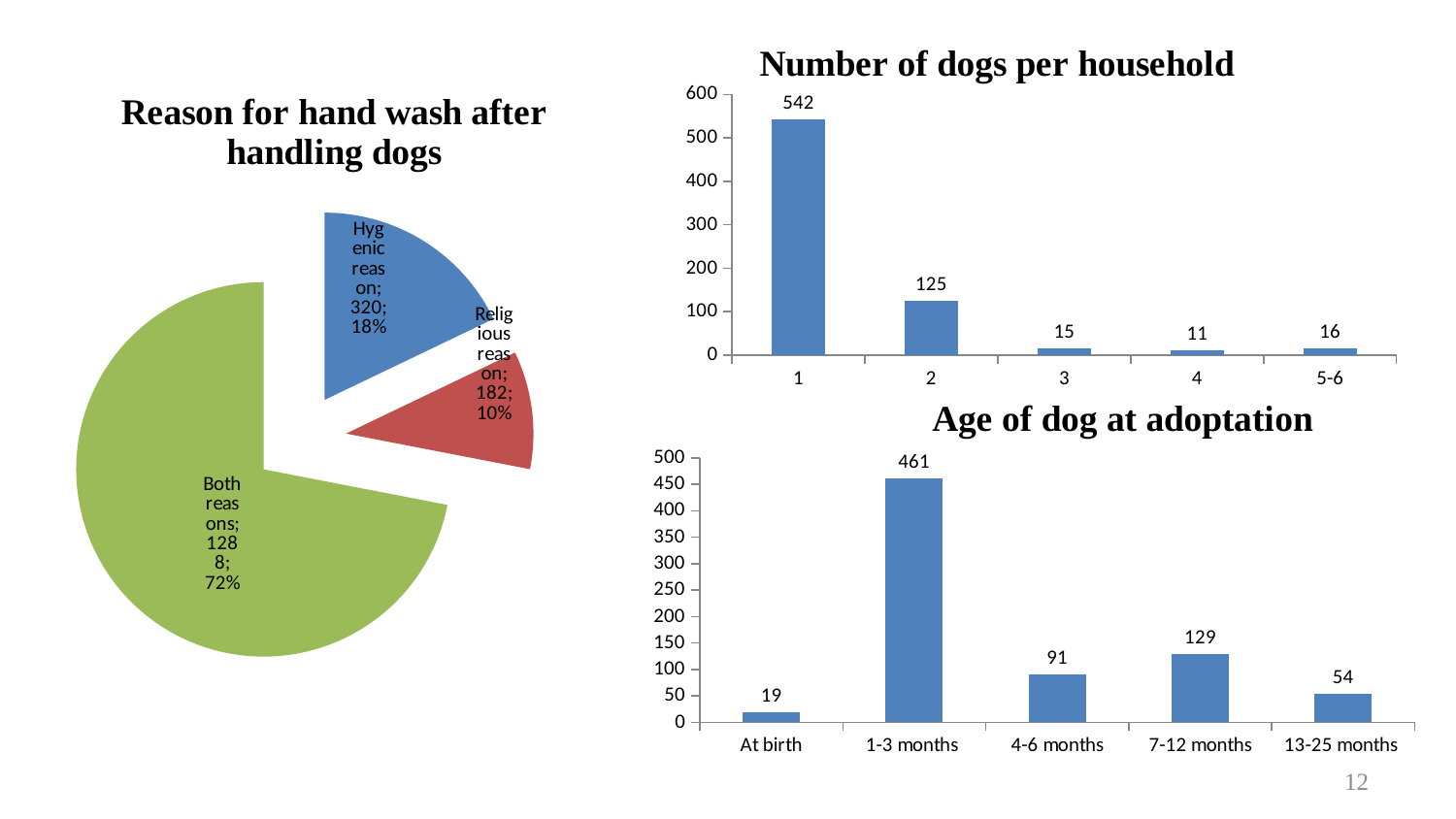
In the 'Reason for hand wash after handling dogs' chart, what is the value for 'Religious reason'? 182 In the 'Age of dog at adoptation' chart, which is larger, the value for 4-6 months or 13-25 months? 4-6 months In the 'Reason for hand wash after handling dogs' chart, what share does 'Both reasons' have? 72% What kind of chart is 'Age of dog at adoptation'? Bar chart In the 'Number of dogs per household' chart, what is the value for 1 dog? 542 In the 'Number of dogs per household' chart, how many categories are shown on the x axis? 5 In the 'Age of dog at adoptation' chart, what is the difference between the values for 1-3 months and At birth? 442 In the 'Number of dogs per household' chart, what is the difference between the values for 1 and 2? 417 In the 'Number of dogs per household' chart, which category has the lowest value? 4 In the 'Age of dog at adoptation' chart, what is the value for 7-12 months? 129 In the 'Age of dog at adoptation' chart, which category has the highest value? 1-3 months What kind of chart is 'Reason for hand wash after handling dogs'? Pie chart